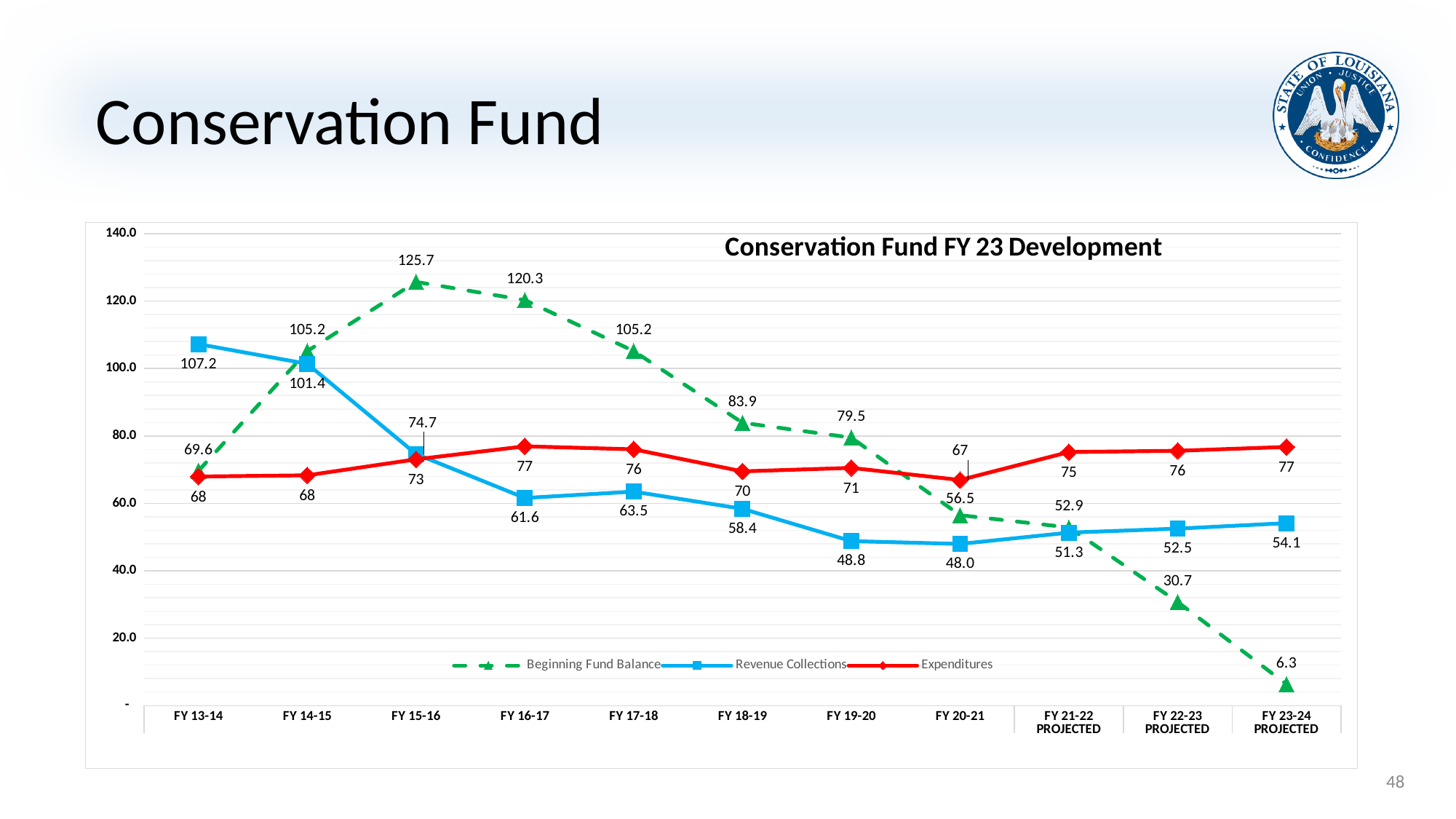
Does the Beginning Fund Balance rise or fall from FY 15-16 to FY 23-24 PROJECTED? fall What is the title of the chart? Conservation Fund FY 23 Development What type of chart is shown on the slide? line chart In which fiscal year is the Revenue Collections value lowest? FY 20-21 What is the Beginning Fund Balance value for FY 15-16? 125.7 What is the difference between Revenue Collections and Expenditures in FY 13-14? 39.2 What is the Expenditures value for FY 23-24 PROJECTED? 77 In which fiscal year is the Beginning Fund Balance highest? FY 15-16 What is the Revenue Collections value for FY 20-21? 48.0 How many fiscal year categories are shown on the x axis? 11 How many series does the legend list? 3 Which is larger in FY 16-17, Expenditures or Revenue Collections? Expenditures